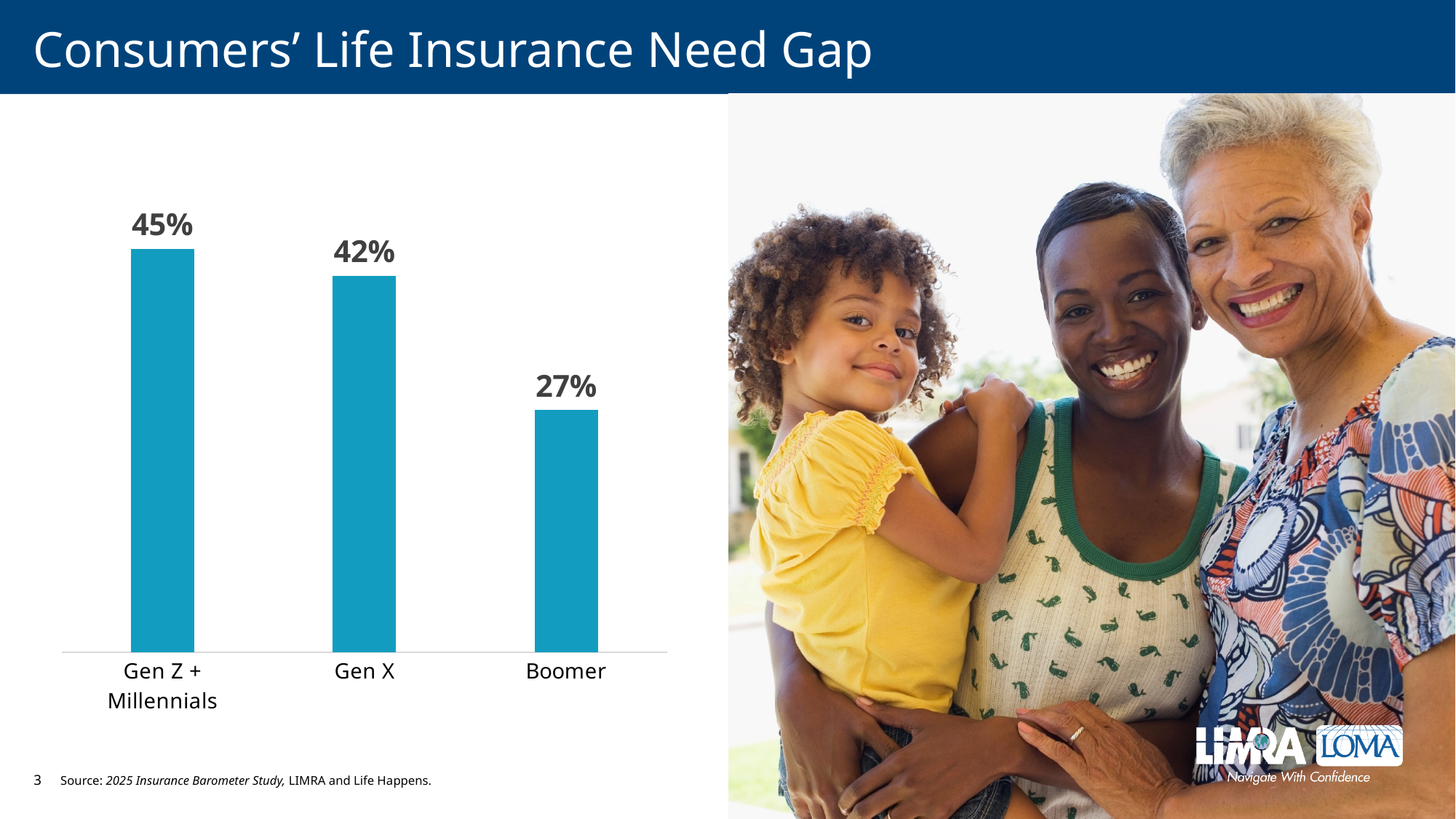
Do the values rise or fall from left to right across the categories? Fall How many categories are shown in the chart? 3 Which is larger, the value for Gen X or the value for Boomer? Gen X What is the title of the slide containing the chart? Consumers' Life Insurance Need Gap Which category has the lowest value? Boomer What is the difference between the values for Gen Z + Millennials and Boomer? 18% Which category has the highest value? Gen Z + Millennials What is the value for Boomer? 27% What is the value for Gen Z + Millennials? 45% What kind of chart is shown on the slide? Bar chart What is the difference between the values for Gen X and Boomer? 15% What is the value for Gen X? 42%